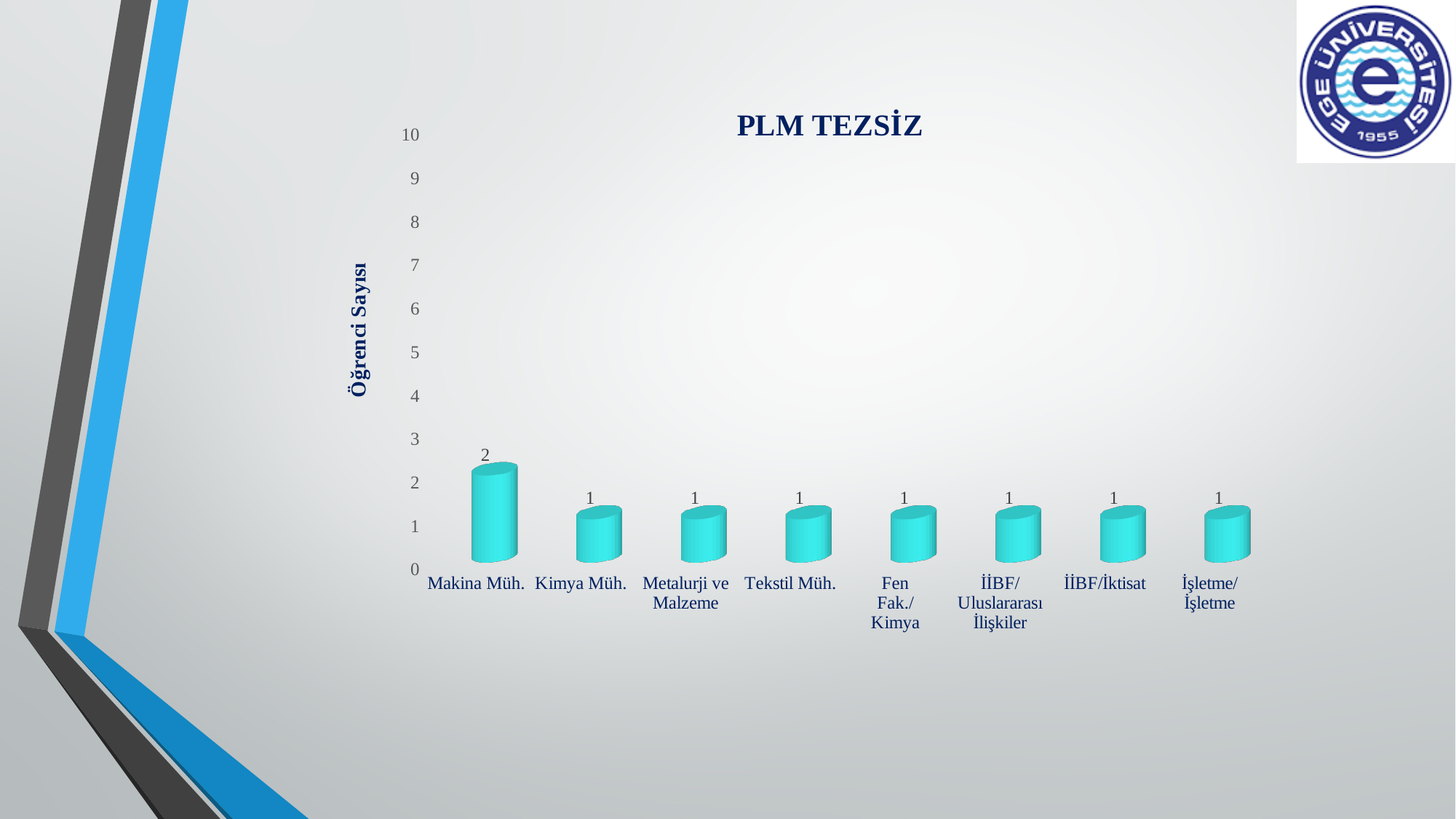
Is the value for Makina Müh. greater or less than 5? less What is the value for Makina Müh.? 2 How many categories are shown on the x axis? 8 What is the title of the chart? PLM TEZSİZ What is the value for İİBF/İktisat? 1 What is the difference between the values for Makina Müh. and Kimya Müh.? 1 Which is larger, the value for Makina Müh. or the value for Fen Fak./Kimya? Makina Müh. Which category has the highest value? Makina Müh. What kind of chart is shown on the slide? bar chart What is the value for Tekstil Müh.? 1 What is the total of the values for Makina Müh., Kimya Müh. and Metalurji ve Malzeme? 4 What is the label of the vertical axis? Öğrenci Sayısı